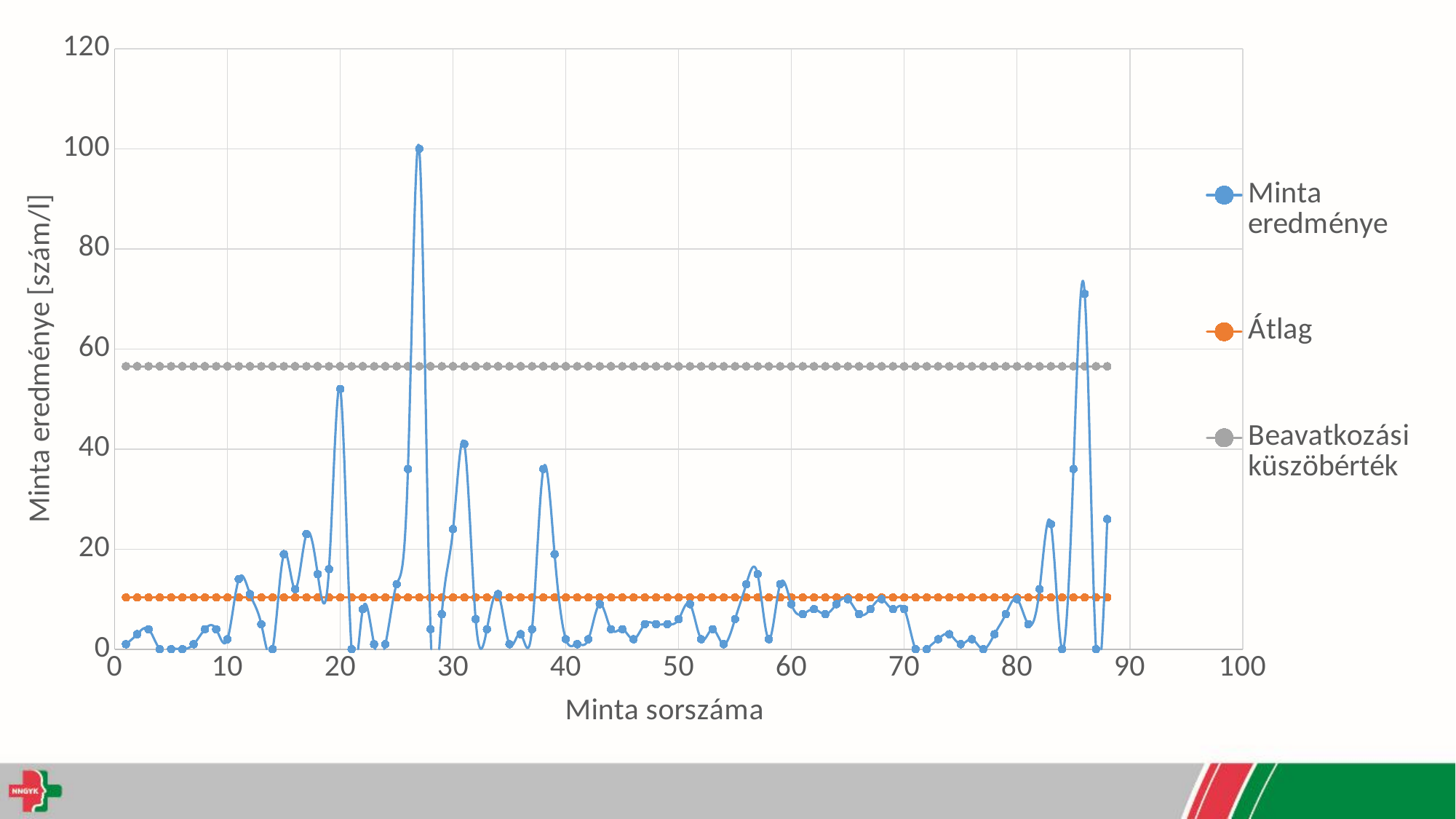
Is the Minta eredménye value at sample 86 greater or less than 60? greater Is the Átlag line greater or less than 20? less Which is larger, the Minta eredménye value at sample 27 or at sample 86? sample 27 Which is higher, the Átlag line or the Beavatkozási küszöbérték line? Beavatkozási küszöbérték What is the title of the x axis? Minta sorszáma Is the Beavatkozási küszöbérték line greater or less than 60? less What is the title of the y axis? Minta eredménye [szám/l] How many series does the legend list? 3 What kind of chart is shown on the slide? line chart Which series is drawn in orange? Átlag